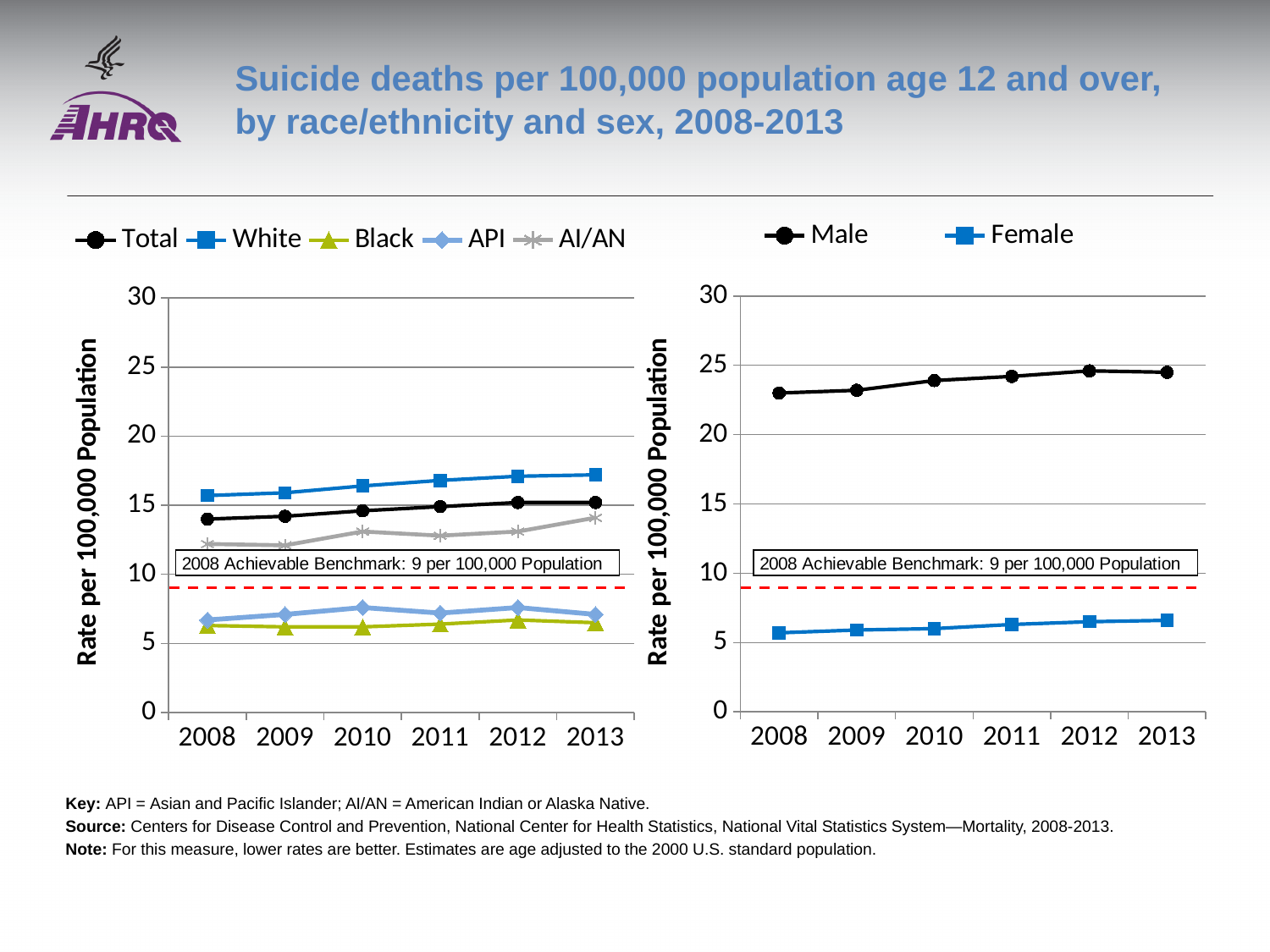
In the right chart (by sex), is the value for Male in 2008 greater or less than 20? greater In the right chart (by sex), how many years are shown on the x axis? 6 What kind of chart is the left chart showing rates by race/ethnicity? line chart In the left chart (by race/ethnicity), how many series does the legend list? 5 In the right chart (by sex), which is larger in 2013, the Male rate or the Female rate? Male What is the 2008 Achievable Benchmark shown on the charts? 9 per 100,000 Population In the right chart (by sex), how many series does the legend list? 2 In the left chart (by race/ethnicity), which series has the highest rate in 2013? White In the right chart (by sex), is the value for Female in 2013 greater or less than 10? less In the left chart (by race/ethnicity), does the White rate rise or fall from 2008 to 2013? rise In the left chart (by race/ethnicity), which series has the lowest rate in 2010? Black In the left chart (by race/ethnicity), is the value for White in 2013 greater or less than 15? greater